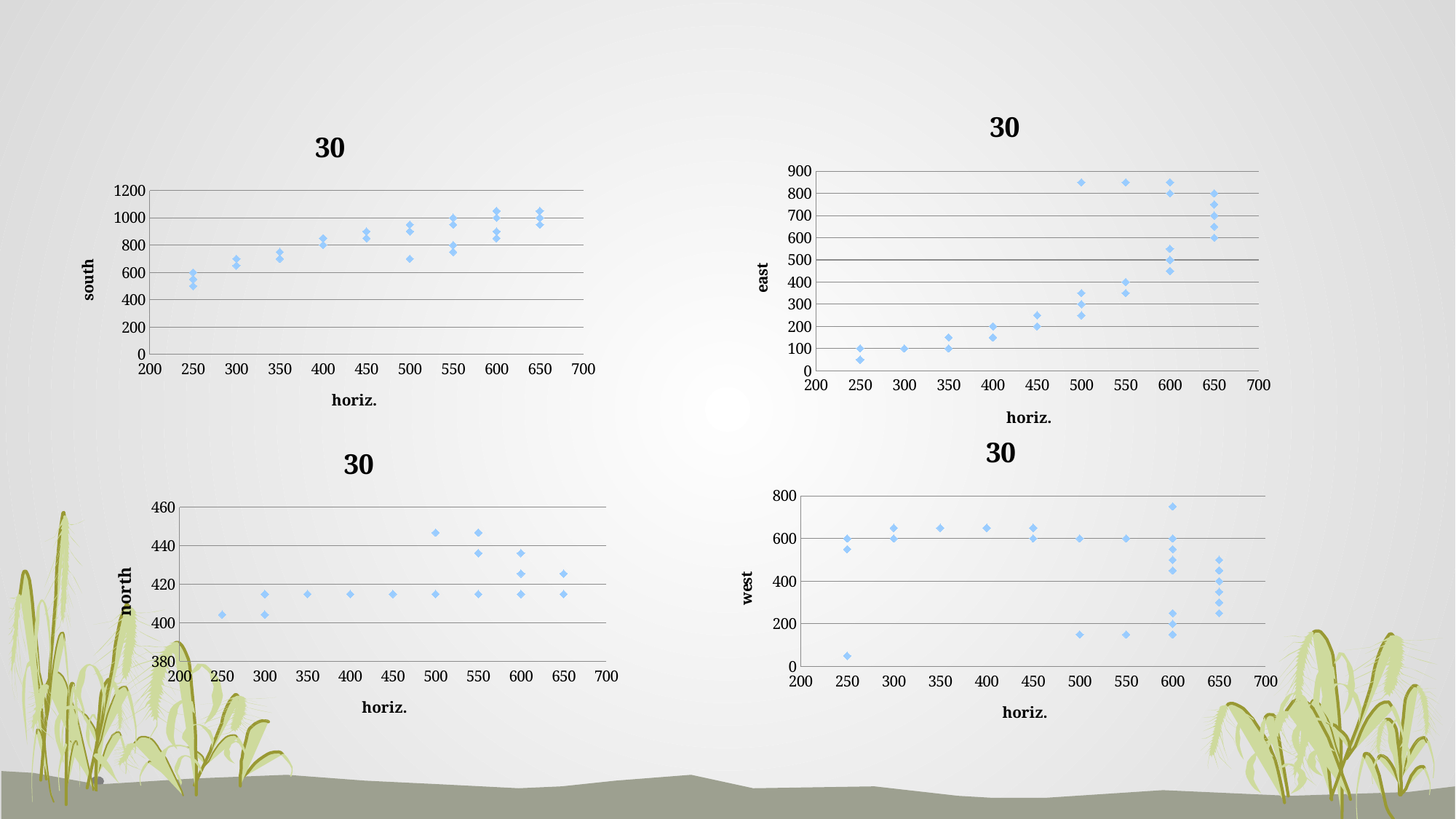
In the top-left chart (y-axis "south"), are the values at horiz. 650 greater or less than 800? greater What is the x-axis label of the top-right chart with the y-axis labelled "east"? horiz. In the top-right chart (y-axis "east"), are the values at horiz. 250 greater or less than 200? less What kind of chart is the top-left chart with the y-axis labelled "south"? scatter chart In the bottom-right chart (y-axis "west"), is the lowest point at horiz. 250 greater or less than 100? less What is the title shown above the bottom-left chart with the y-axis labelled "north"? 30 In the top-right chart (y-axis "east"), do the plotted values generally rise or fall as horiz. increases from 250 to 650? rise In the top-left chart (y-axis "south"), do the plotted values generally rise or fall as horiz. increases from 250 to 650? rise How many charts are shown on the slide? 4